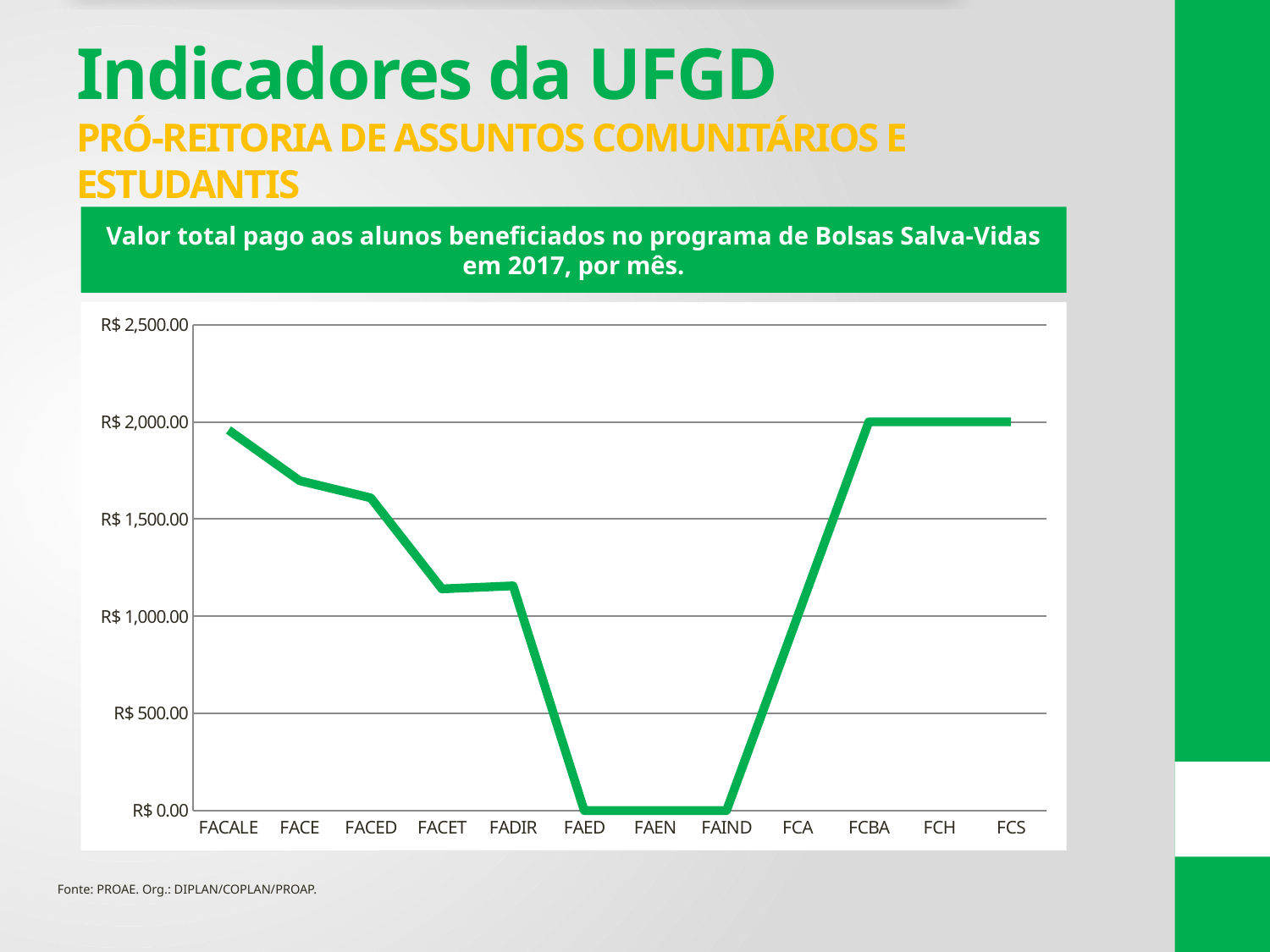
Is the value for FACALE greater or less than R$ 1,500.00? greater What kind of chart is shown on the slide? line chart What is the value for FAIND? R$ 0.00 Which has the larger value, FACALE or FACET? FACALE Is the value for FADIR greater or less than R$ 1,000.00? greater Do the values rise or fall from FACALE to FADIR? fall Is the value for FACET greater or less than R$ 1,500.00? less What is the title of the chart? Valor total pago aos alunos beneficiados no programa de Bolsas Salva-Vidas em 2017, por mês. How many categories are shown on the x axis of the chart? 12 What is the value for FAED? R$ 0.00 What is the value for FCH? R$ 2,000.00 Do the values rise or fall from FAIND to FCBA? rise